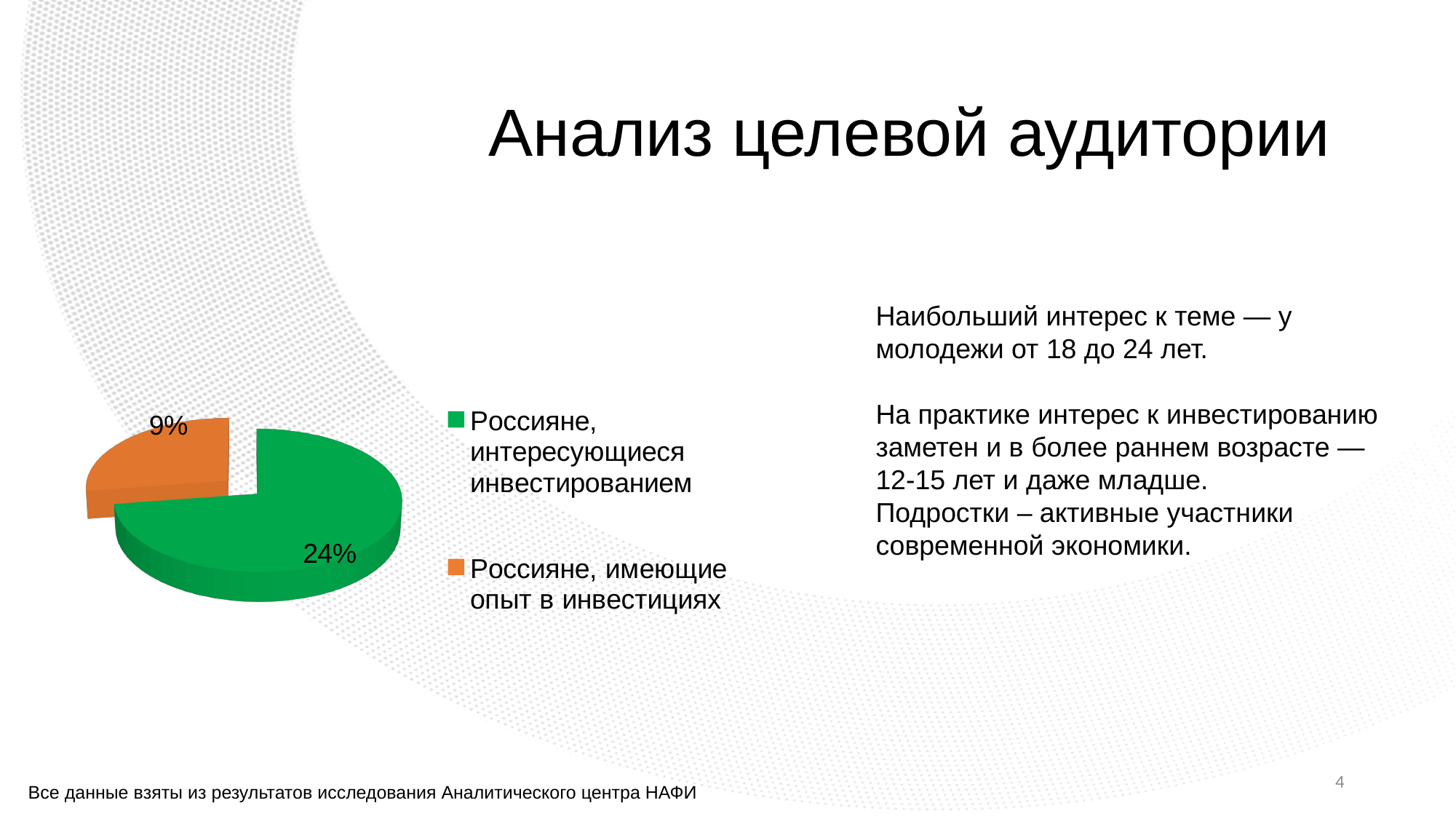
How many entries does the legend list? 2 What colour is the slice for "Россияне, интересующиеся инвестированием"? Green Which category has the largest slice of the pie? Россияне, интересующиеся инвестированием What kind of chart is shown on the slide? Pie chart Which category has the smallest slice of the pie? Россияне, имеющие опыт в инвестициях What is the value of the orange slice? 9% How many slices does the pie chart have? 2 What is the difference between the values for "Россияне, интересующиеся инвестированием" and "Россияне, имеющие опыт в инвестициях"? 15 percentage points What colour is the slice for "Россияне, имеющие опыт в инвестициях"? Orange What value is shown for "Россияне, имеющие опыт в инвестициях"? 9% Which is larger: the value for "Россияне, интересующиеся инвестированием" or for "Россияне, имеющие опыт в инвестициях"? Россияне, интересующиеся инвестированием What value is shown for "Россияне, интересующиеся инвестированием"? 24%